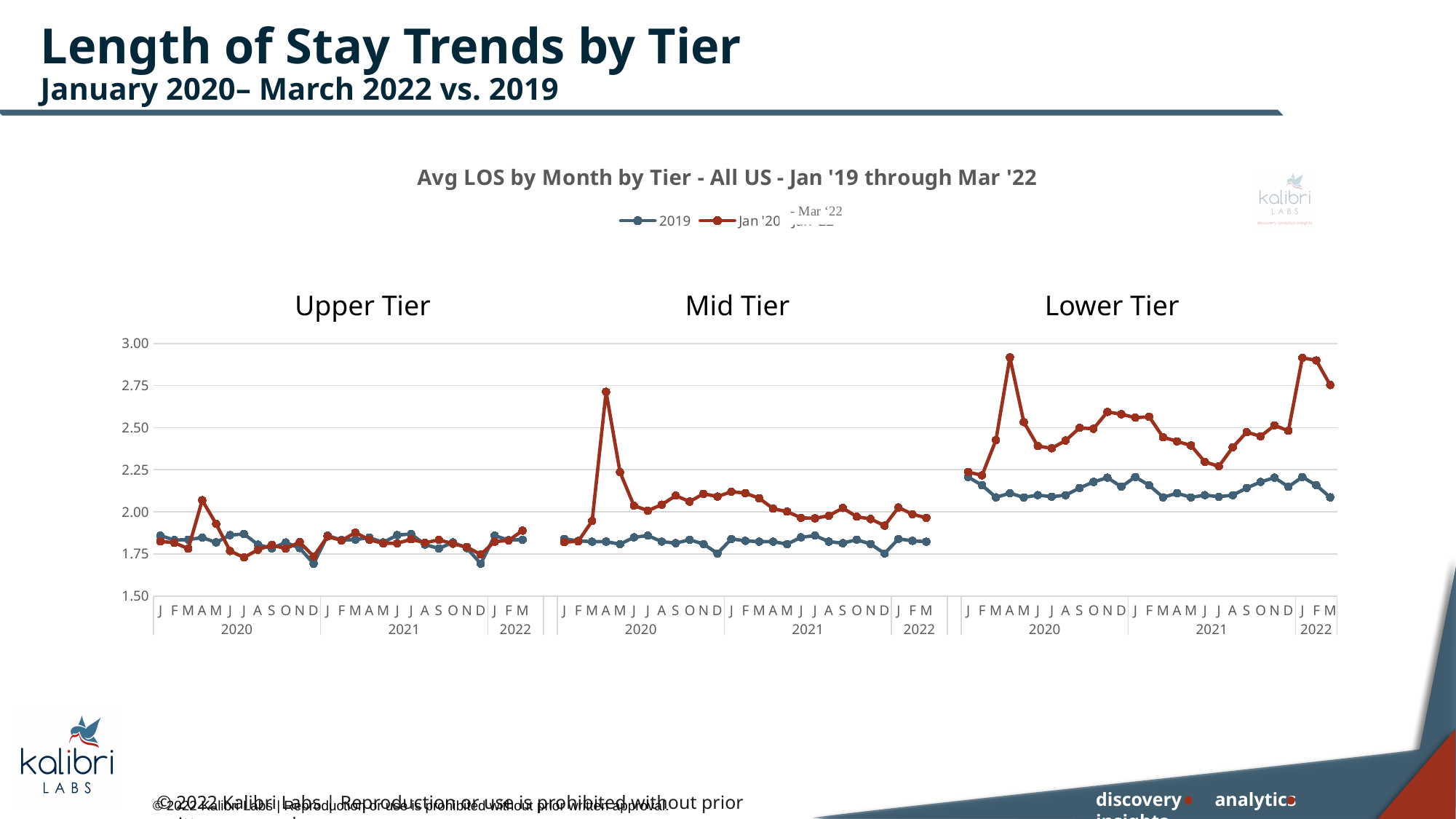
In the Lower Tier panel, is the Jan '20 - Mar '22 line generally above or below the 2019 line? above Which tier panel reaches the highest average length of stay? Lower Tier How many series does the chart legend list? 2 In the Lower Tier panel, does the 2019 line stay greater or less than 2.50 throughout? less Which colour is used for the 2019 series? blue In the Mid Tier panel, does the Jan '20 - Mar '22 line rise or fall from April 2020 to July 2020? fall In the Upper Tier panel, does the 2019 line stay greater or less than 2.00 throughout? less In the Mid Tier panel, is the peak value of the Jan '20 - Mar '22 line in 2020 greater or less than 2.50? greater What kind of chart is shown on the slide? line chart What is the title of the chart? Avg LOS by Month by Tier - All US - Jan '19 through Mar '22 How many tier panels does the chart contain? 3